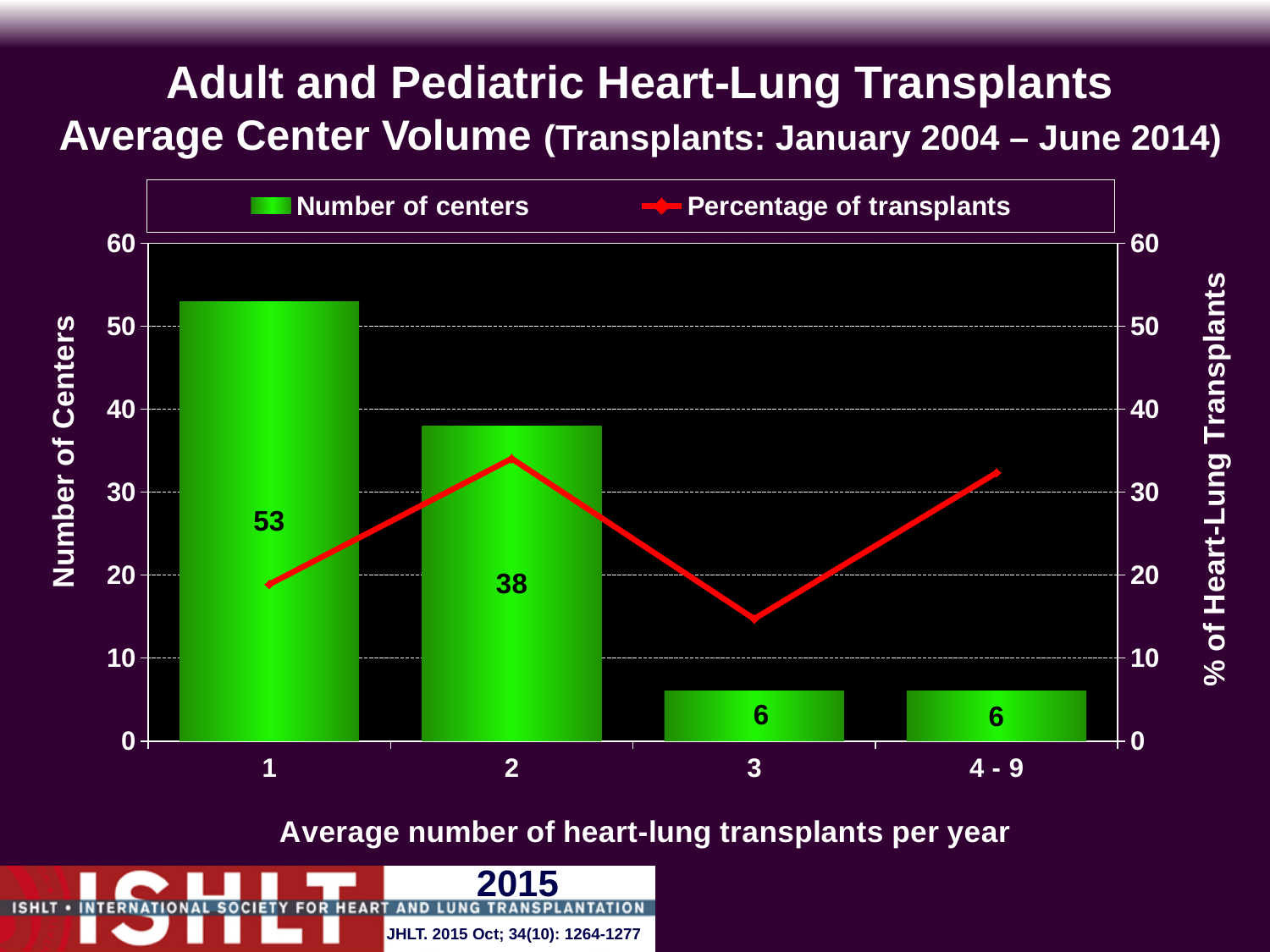
How many series does the legend list? 2 Which category has the highest number of centers? 1 What is the number of centers for the category 2? 38 What is the number of centers for the category 4 - 9? 6 Is the percentage of transplants for category 2 greater or less than 30? greater What is the number of centers for the category 1? 53 Is the percentage of transplants for category 3 greater or less than 20? less Do the number of centers values rise or fall from category 1 to category 3? fall What is the difference in number of centers between category 1 and category 2? 15 What is the label of the left vertical axis? Number of Centers How many categories are shown on the x axis? 4 Which has more centers, category 2 or category 3? 2